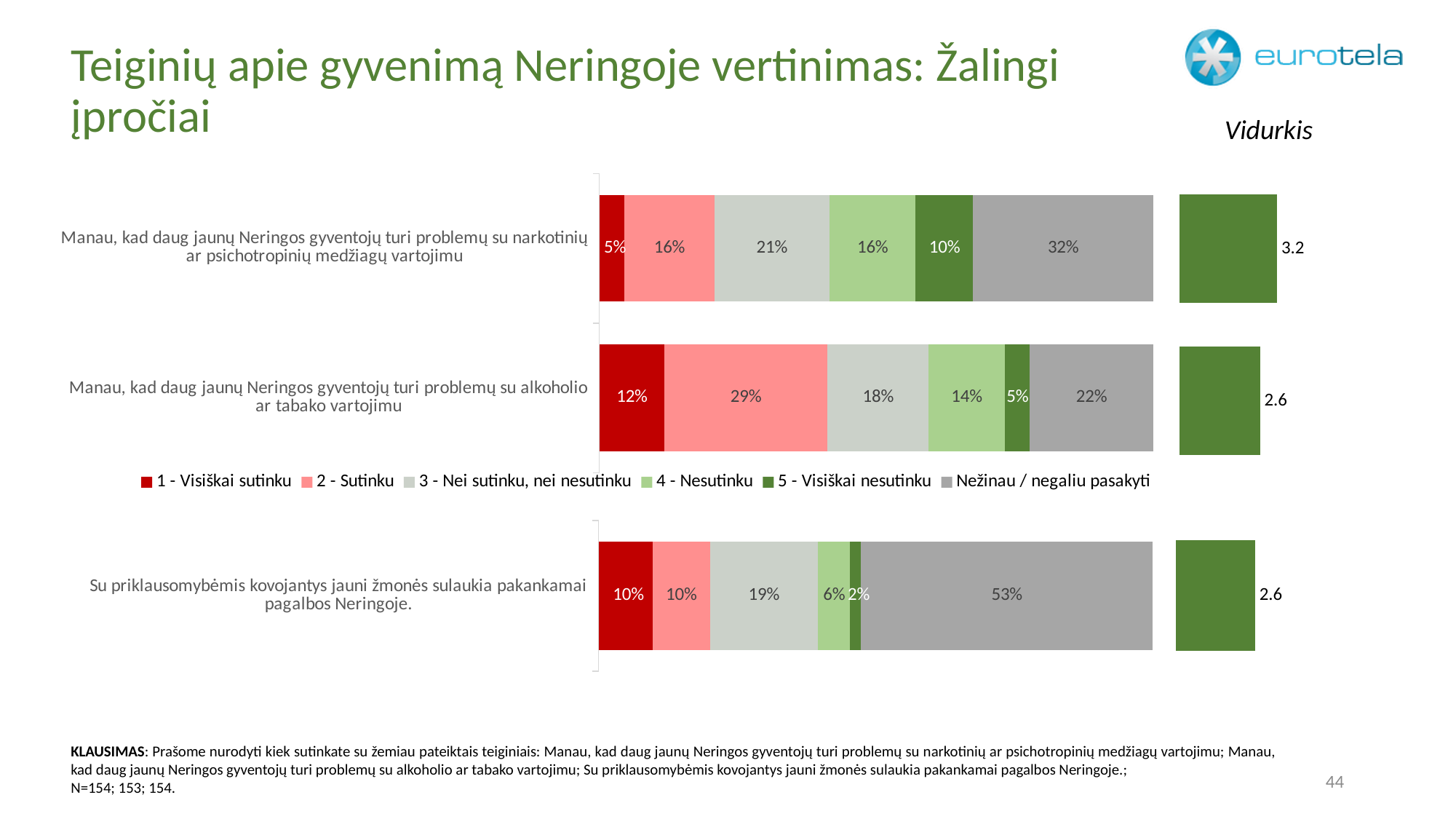
Which statement has the highest "Vidurkis" (average) value? Manau, kad daug jaunų Neringos gyventojų turi problemų su narkotinių ar psichotropinių medžiagų vartojimu What kind of chart is used to show the response distribution for each statement? Stacked bar chart In the stacked bar chart, is the "1 - Visiškai sutinku" share larger for the alcohol/tobacco statement or for the narcotics statement? The alcohol/tobacco statement Which statement has the smallest "5 - Visiškai nesutinku" share in the stacked bar chart? Su priklausomybėmis kovojantys jauni žmonės sulaukia pakankamai pagalbos Neringoje. How many statements are plotted across the stacked bar charts on the slide? 3 In the stacked bar chart, what percentage chose "5 - Visiškai nesutinku" for the statement about young Neringa residents having problems with narcotic or psychotropic substance use? 10% In the stacked bar chart, what percentage chose "2 - Sutinku" for the statement about young Neringa residents having problems with alcohol or tobacco use? 29% How many series does the legend of the stacked bar chart list? 6 In the "Vidurkis" bars on the right, what is the average value for the statement about narcotic or psychotropic substance use? 3.2 Which statement has the largest "Nežinau / negaliu pasakyti" share in the stacked bar chart? Su priklausomybėmis kovojantys jauni žmonės sulaukia pakankamai pagalbos Neringoje. In the stacked bar chart, what percentage of respondents answered "Nežinau / negaliu pasakyti" for the statement "Su priklausomybėmis kovojantys jauni žmonės sulaukia pakankamai pagalbos Neringoje."? 53% In the stacked bar chart, what is the difference between the "2 - Sutinku" share for the alcohol/tobacco statement and the "2 - Sutinku" share for the narcotics statement? 13 percentage points